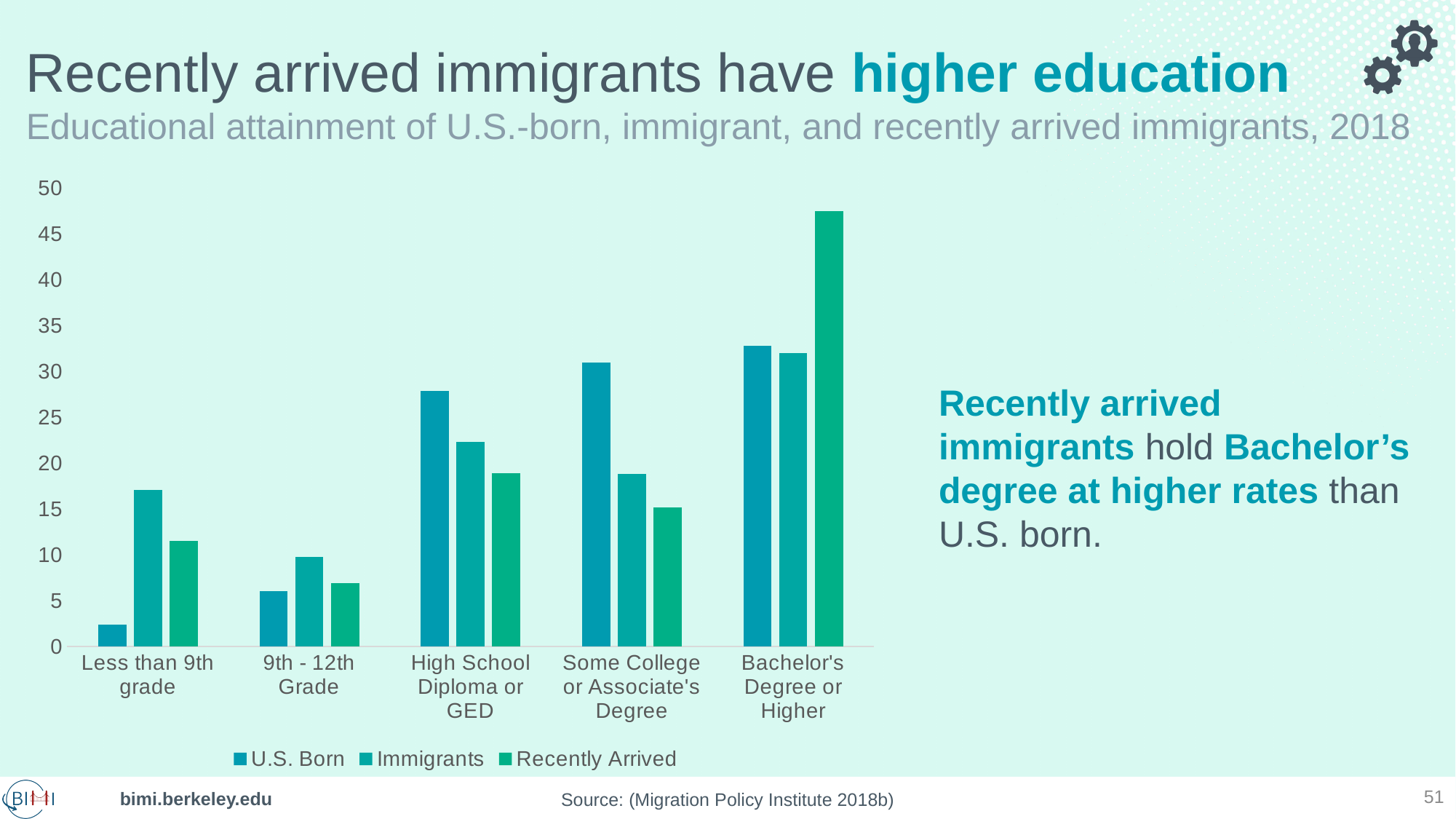
For the U.S. Born series, which category has the lowest value? Less than 9th grade Is the Recently Arrived value for Bachelor's Degree or Higher greater or less than 45? greater Is the U.S. Born value for Some College or Associate's Degree greater or less than 30? greater In the Some College or Associate's Degree category, which series has the highest value? U.S. Born For the Recently Arrived series, which category has the highest value? Bachelor's Degree or Higher Is the Immigrants value for 9th - 12th Grade greater or less than 15? less How many educational attainment categories are shown on the x axis? 5 What kind of chart is shown on the slide? Bar chart In the Less than 9th grade category, which is larger: U.S. Born or Immigrants? Immigrants What are the three series listed in the legend? U.S. Born, Immigrants, Recently Arrived How many series does the legend list? 3 In the Bachelor's Degree or Higher category, which is larger: U.S. Born or Recently Arrived? Recently Arrived